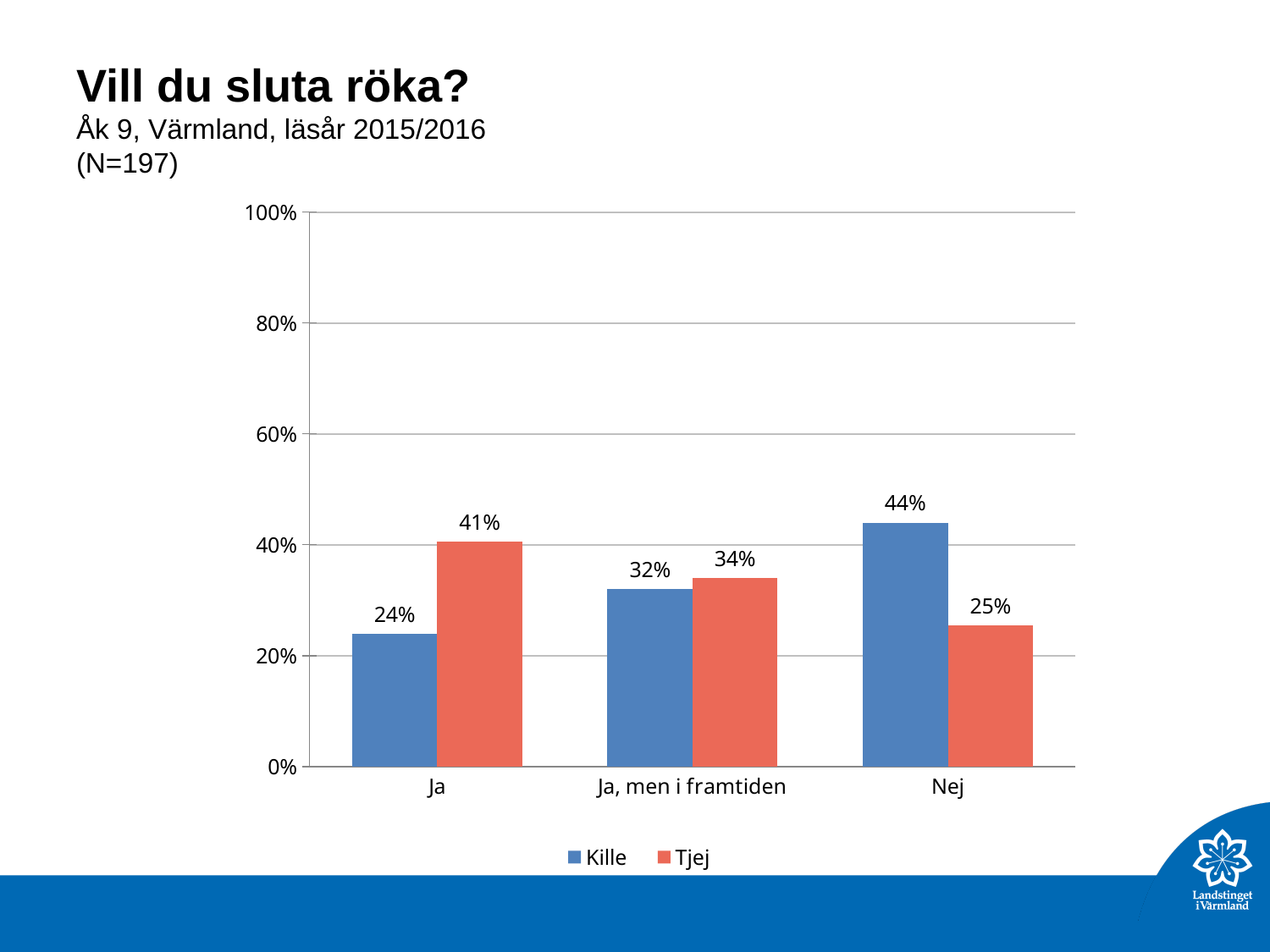
Is the value for Kille in the "Nej" category greater or less than 40%? greater What is the value for Tjej in the "Ja, men i framtiden" category? 34% Which category has the highest value for Kille? Nej What is the difference between the Tjej and Kille values in the "Ja" category? 17% How many categories are shown on the x axis? 3 Which is larger in the "Nej" category, Kille or Tjej? Kille What kind of chart is shown on the slide? Bar chart What is the value for Kille in the "Ja" category? 24% Which category has the lowest value for Tjej? Nej What is the title of the slide? Vill du sluta röka? What is the value for Tjej in the "Nej" category? 25% How many series does the legend list? 2